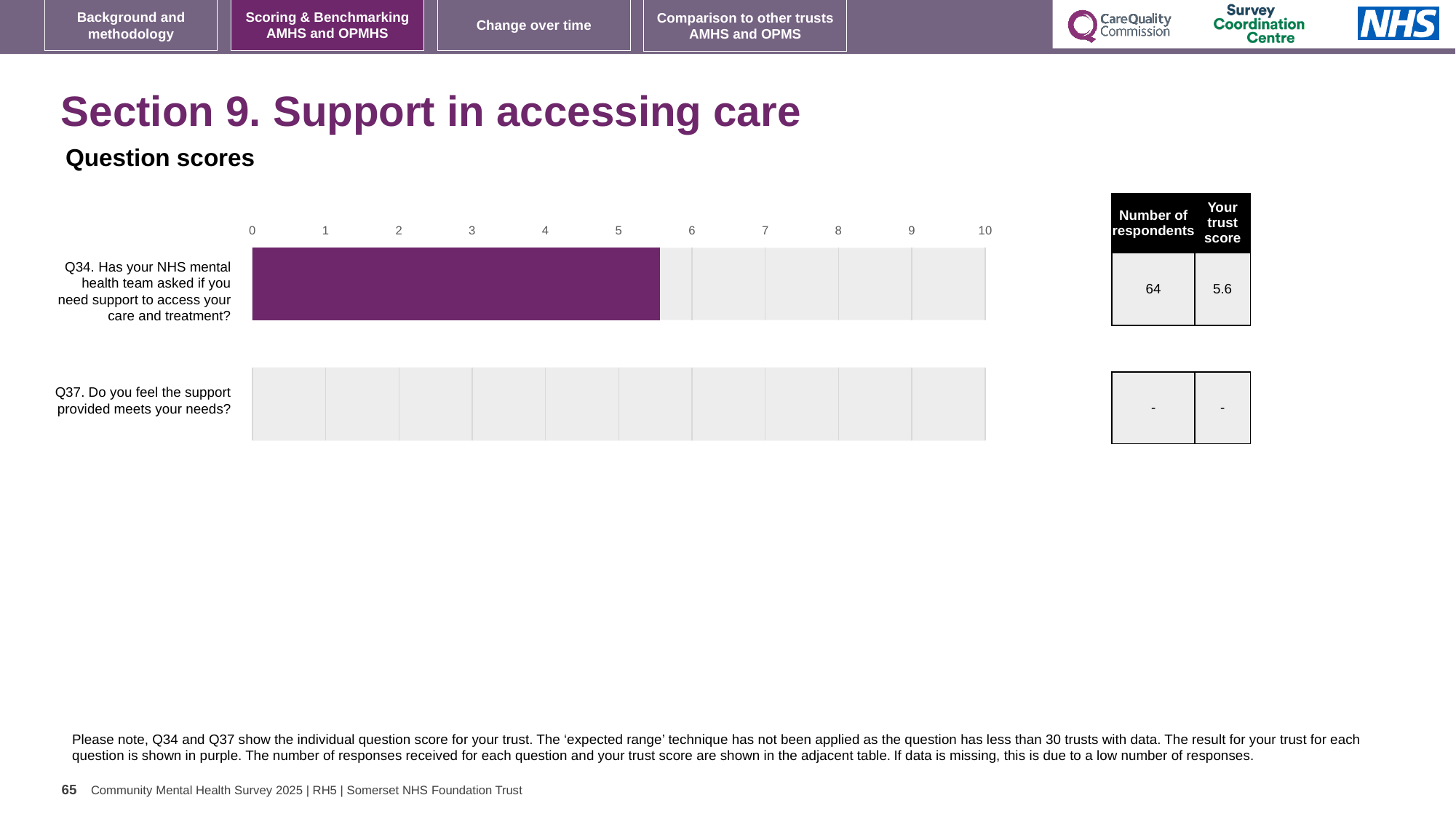
What is the trust score for Q34 (Has your NHS mental health team asked if you need support to access your care and treatment?)? 5.6 How many respondents answered Q34? 64 Is the value for Q34 greater or less than 5? greater What is the title of the section shown on the slide? Section 9. Support in accessing care What is the maximum value shown on the chart's axis? 10 Is the value for Q34 greater or less than 6? less What is the trust score shown for Q37 (Do you feel the support provided meets your needs?)? - How many questions are listed on the chart? 2 What type of chart is shown on the slide? bar chart Which question has a purple bar plotted on the chart? Q34